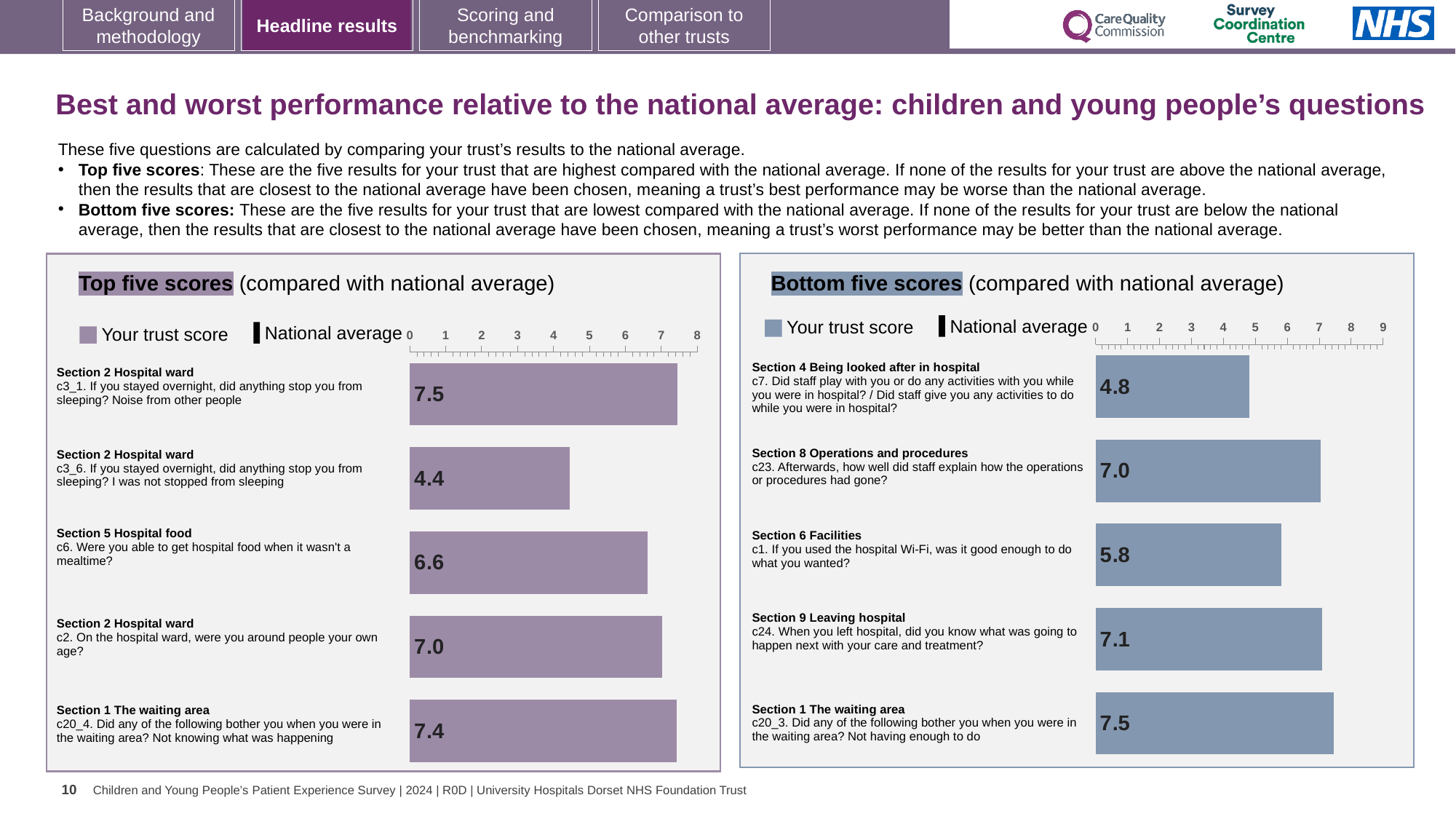
In the 'Top five scores' chart, how many questions are plotted? 5 How many entries does the legend of the 'Bottom five scores' chart list? 2 In the 'Bottom five scores' chart, what is the difference between the trust scores for c20_3 and c7? 2.7 What type of chart is used in the 'Top five scores' panel? Bar chart In the 'Top five scores' chart, what is the trust score for c6 (able to get hospital food when it wasn't a mealtime)? 6.6 In the 'Bottom five scores' chart, which question has the highest trust score? c20_3. Did any of the following bother you when you were in the waiting area? Not having enough to do In the 'Bottom five scores' chart, what is the trust score for c7 (did staff play with you or do any activities with you)? 4.8 In the 'Top five scores' chart, what is the trust score for c3_1 (noise from other people stopping you from sleeping)? 7.5 In the 'Bottom five scores' chart, which is larger: the trust score for c23 or for c24? c24 In the 'Top five scores' chart, what is the difference between the trust scores for c3_1 and c3_6? 3.1 In the 'Bottom five scores' chart, what is the trust score for c1 (hospital Wi-Fi good enough)? 5.8 In the 'Top five scores' chart, which question has the lowest trust score? c3_6. If you stayed overnight, did anything stop you from sleeping? I was not stopped from sleeping